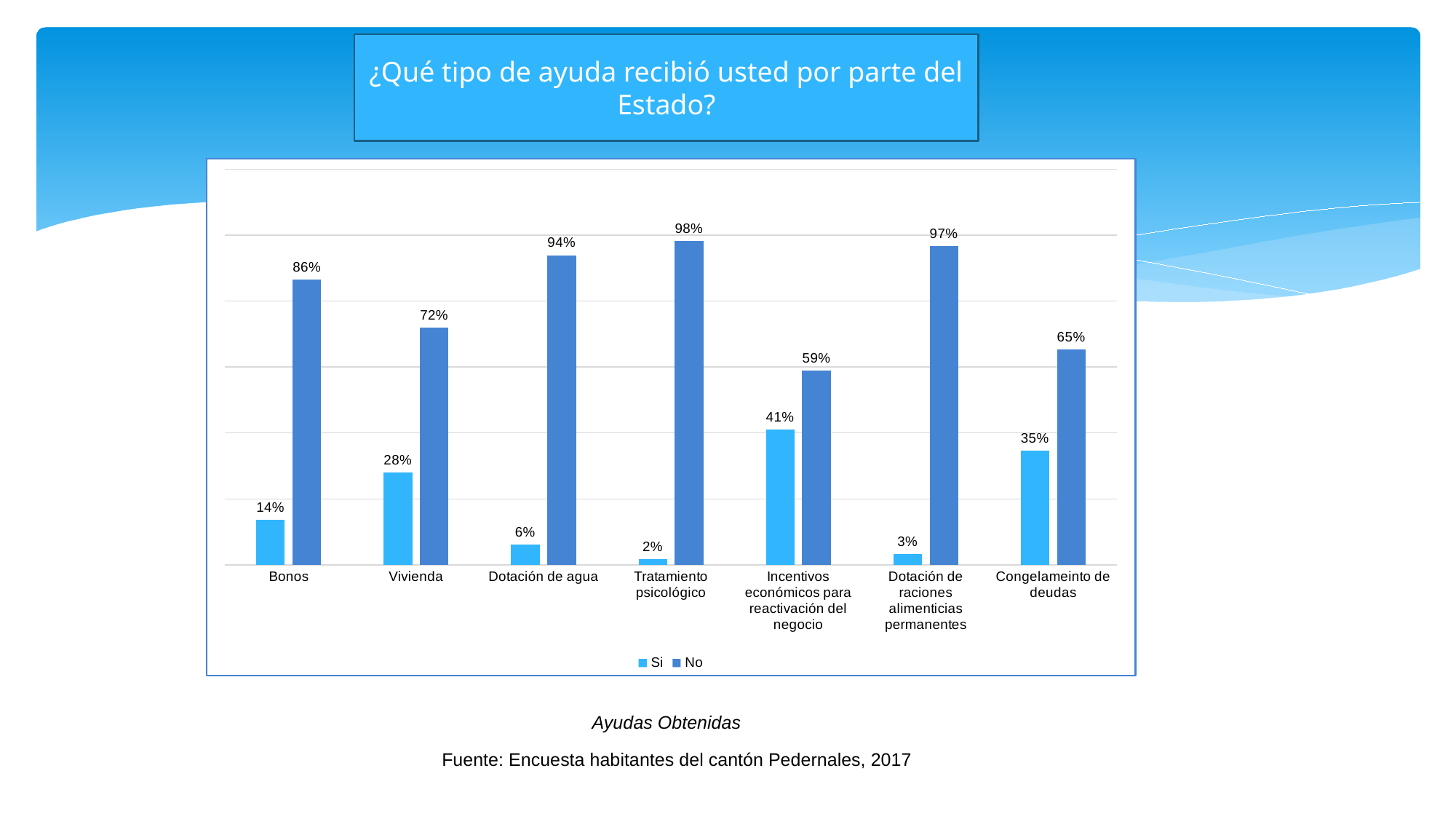
What is the 'Si' value for Incentivos económicos para reactivación del negocio? 41% Which category has the lowest 'Si' value? Tratamiento psicológico Which is larger: the 'Si' value for Vivienda or the 'Si' value for Congelameinto de deudas? Congelameinto de deudas Which category has the highest 'Si' value? Incentivos económicos para reactivación del negocio How many categories are shown on the x axis? 7 What is the 'No' value for Tratamiento psicológico? 98% Which category has the lowest 'No' value? Incentivos económicos para reactivación del negocio What is the 'Si' value for Bonos? 14% What is the difference between the 'No' and 'Si' values for Vivienda? 44% What is the 'No' value for Congelameinto de deudas? 65% How many series does the legend list? 2 What kind of chart is shown on the slide? Bar chart